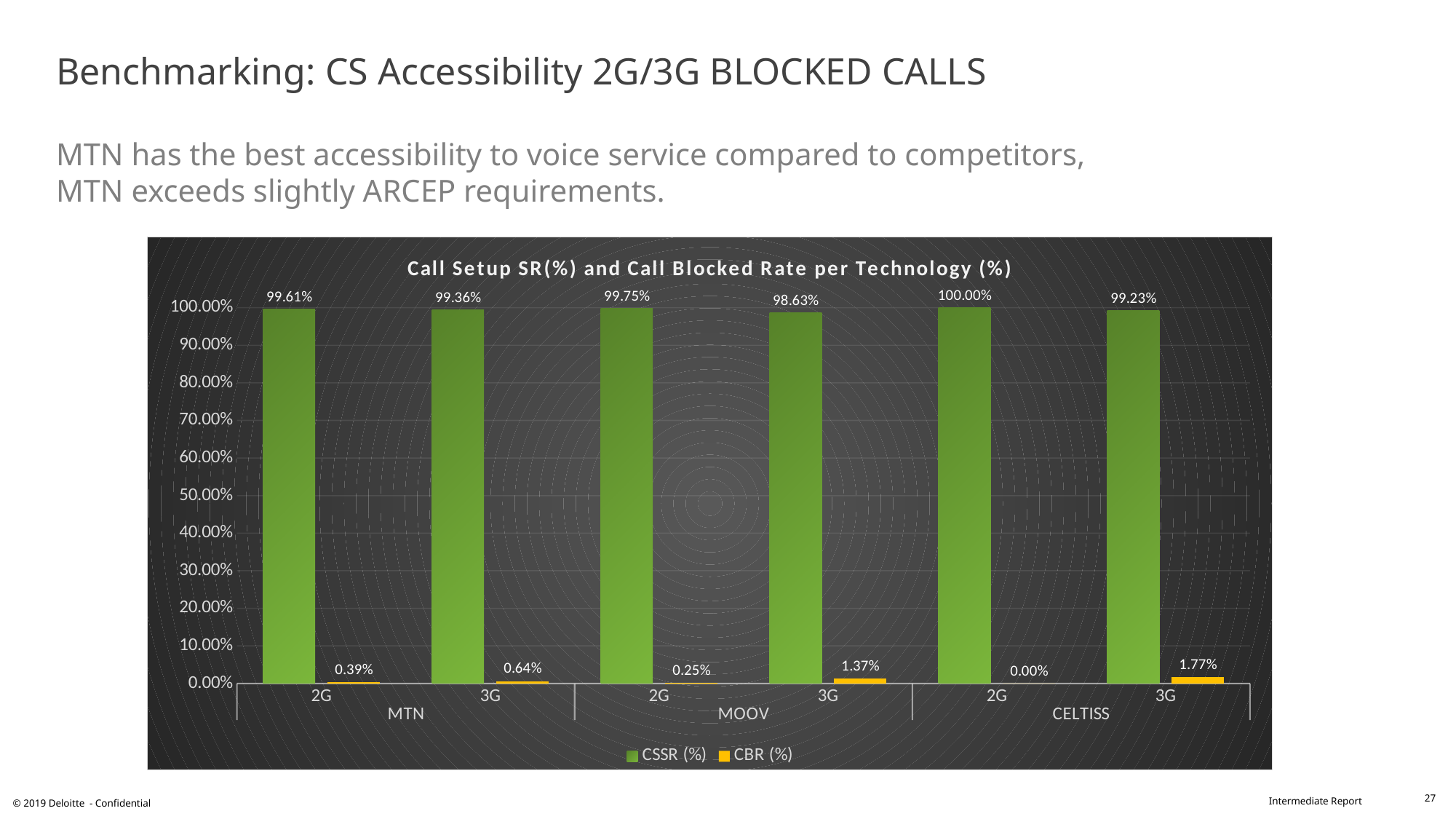
Which is larger, the CSSR (%) for MOOV 2G or for MOOV 3G? MOOV 2G Which operator and technology has the lowest CSSR (%)? MOOV 3G What kind of chart is shown on the slide? Bar chart Which operator and technology has the highest CBR (%)? CELTISS 3G What is the CBR (%) value for MOOV 3G? 1.37% What is the CBR (%) value for CELTISS 3G? 1.77% What is the CSSR (%) value for CELTISS 2G? 100.00% What is the title of the chart? Call Setup SR(%) and Call Blocked Rate per Technology (%) What is the CSSR (%) value for MTN 2G? 99.61% How many operators are shown on the x axis? 3 How many series does the legend list? 2 What is the difference between the CBR (%) for MTN 3G and MTN 2G? 0.25%